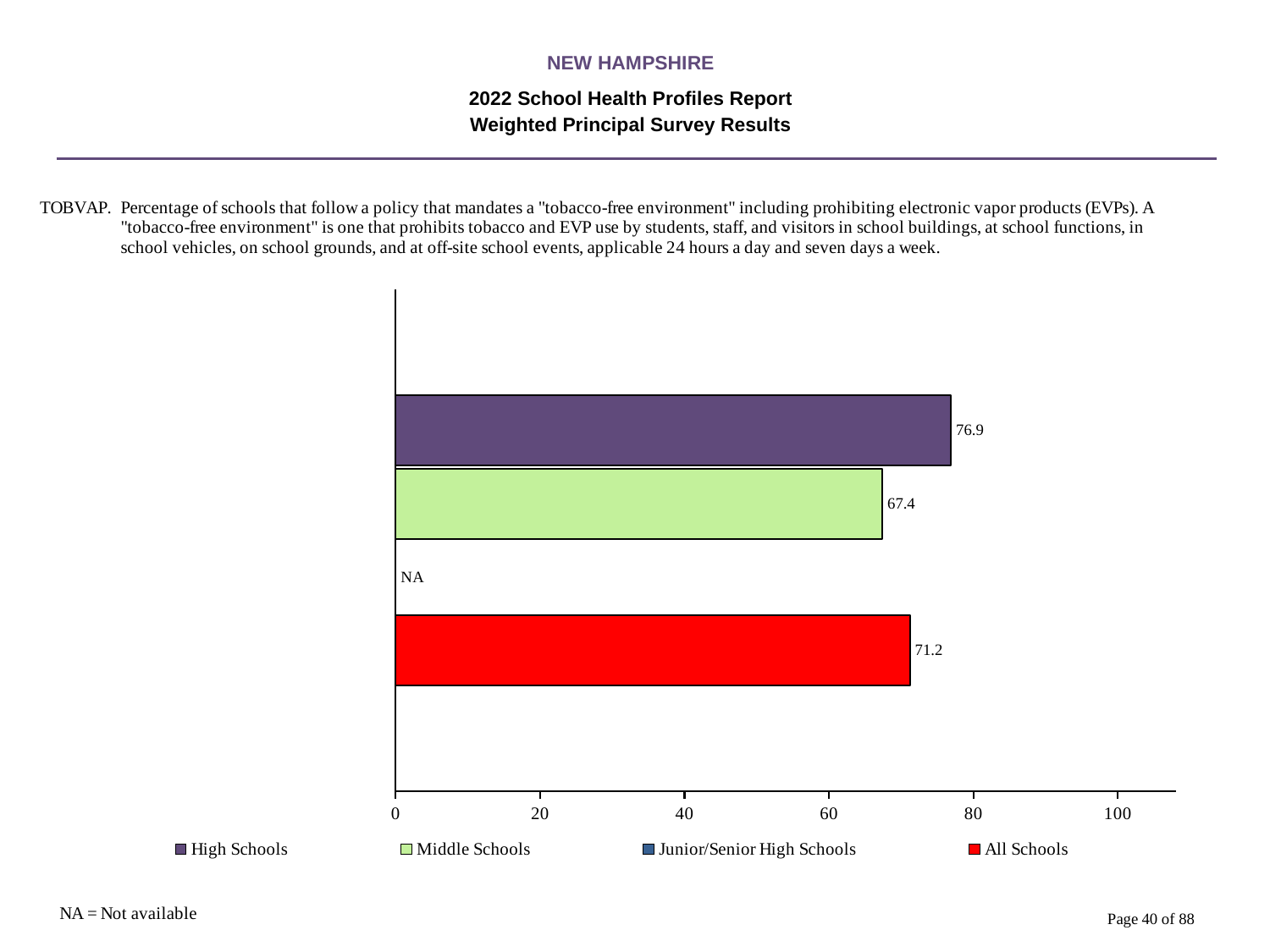
What is the value for All Schools? 71.2 Which is larger, the value for High Schools or the value for All Schools? High Schools How many series does the legend list? 4 What is the value for High Schools? 76.9 What is the difference between the All Schools value and the Middle Schools value? 3.8 What is the difference between the High Schools value and the Middle Schools value? 9.5 What is shown for Junior/Senior High Schools? NA What is the value for Middle Schools? 67.4 Among the school types with a plotted value, which has the lowest value? Middle Schools Is the value for Middle Schools greater or less than 60? greater What kind of chart is shown on the slide? Bar chart Which school type has the highest value? High Schools